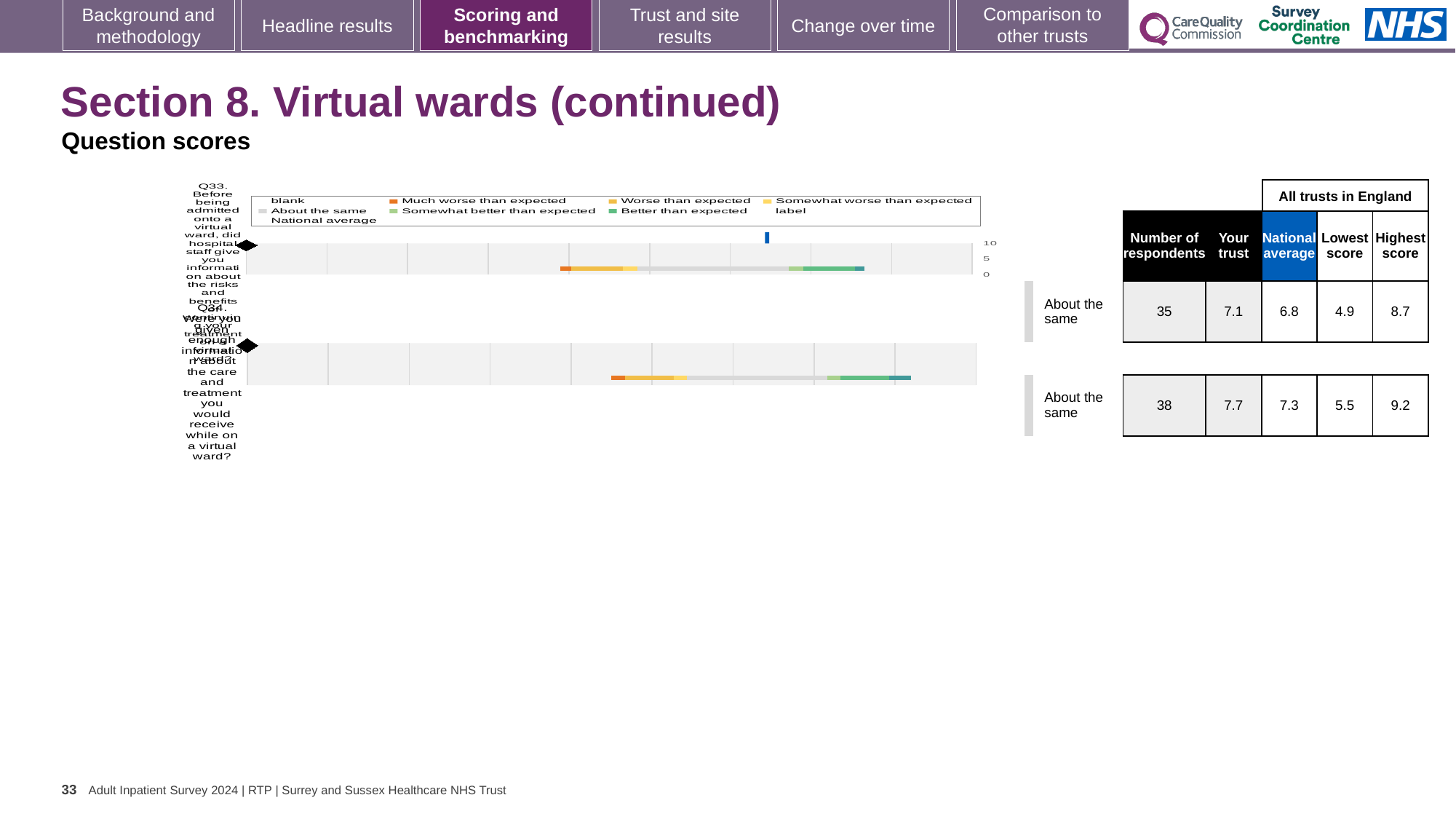
What is the 'Your trust' score for Q33? 7.1 What is the highest score among all trusts in England for Q34? 9.2 What is the lowest score among all trusts in England for Q33? 4.9 How many questions (rows) are plotted in the chart? 2 By how much does the trust's score for Q34 exceed the national average for Q34? 0.4 What is the difference between the highest and lowest scores for Q33? 3.8 What benchmark category is shown for Q33? About the same What kind of chart is used to show the question scores for Q33 and Q34? bar chart What is the national average score for Q34? 7.3 What colour does the legend use for 'Much worse than expected'? orange Which question has the higher 'Your trust' score, Q33 or Q34? Q34 How many respondents answered Q33? 35